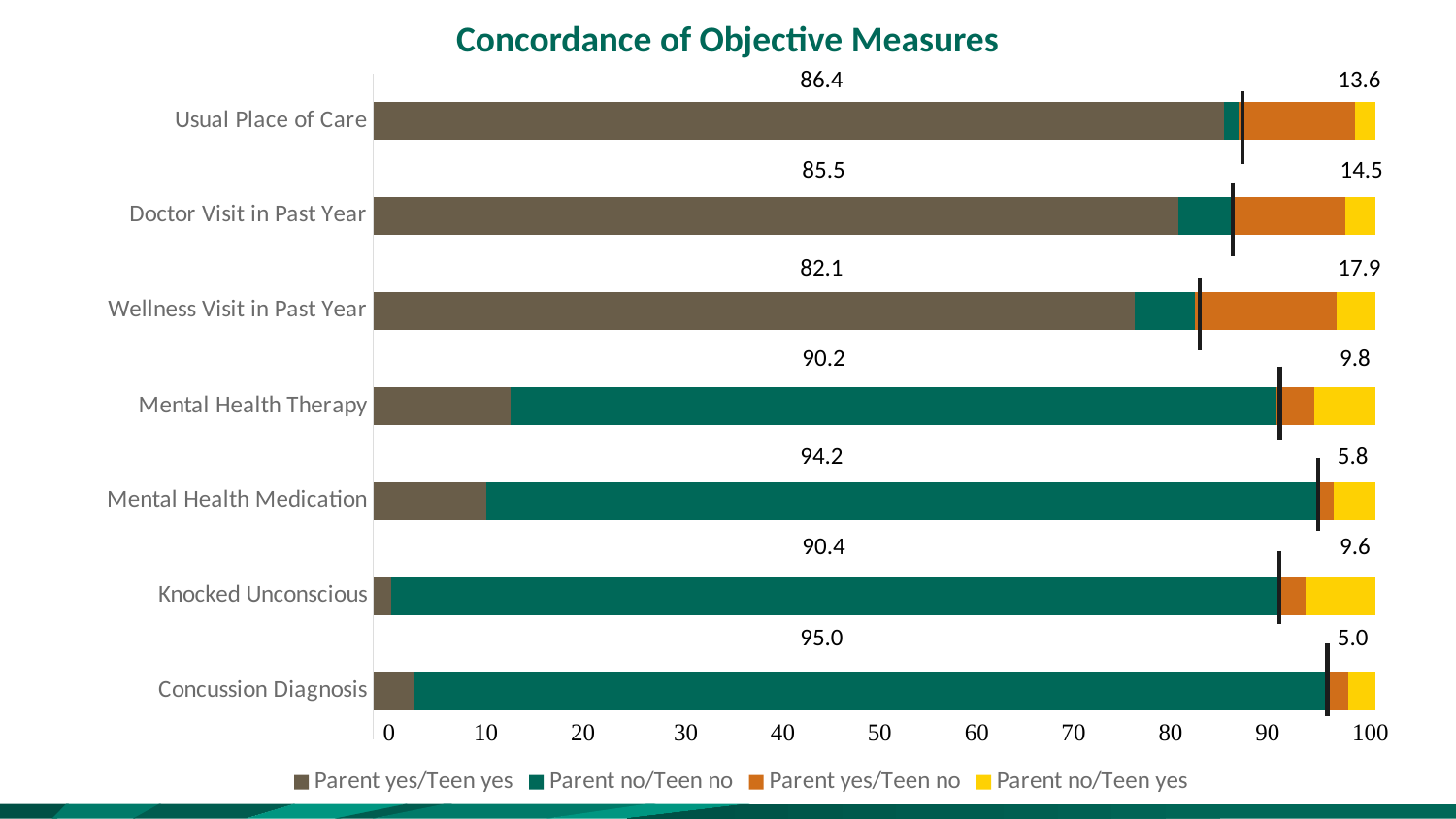
Which category has the highest larger printed value (concordance) above its bar? Concussion Diagnosis What is the larger value printed above the bar for Usual Place of Care? 86.4 What is the difference between the larger printed values for Concussion Diagnosis (95.0) and Wellness Visit in Past Year (82.1)? 12.9 How many series does the legend list? 4 What is the value printed at the right end above the bar for Wellness Visit in Past Year? 17.9 Which category has the lowest larger printed value (concordance) above its bar? Wellness Visit in Past Year Is the Parent yes/Teen yes segment for Knocked Unconscious greater or less than 10? less How many categories (bars) are shown in the chart? 7 What is the title of the chart? Concordance of Objective Measures Which has a larger right-end printed value: Doctor Visit in Past Year or Usual Place of Care? Doctor Visit in Past Year What type of chart is shown on the slide? Stacked bar chart What is the larger value printed above the bar for Mental Health Medication? 94.2